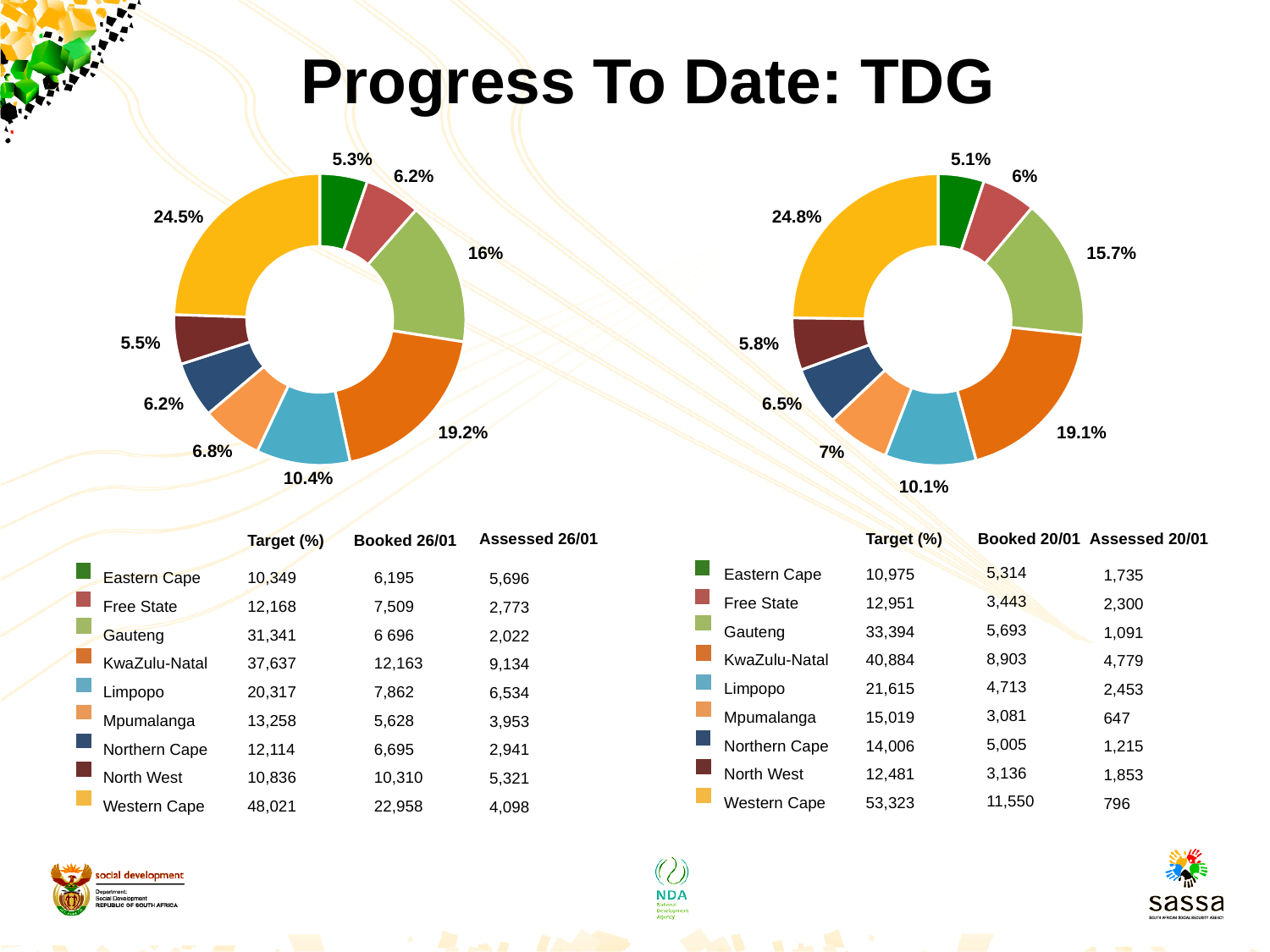
How many slices does the left donut chart have? 9 In the right donut chart, which province has the smallest share? Eastern Cape In the left donut chart, which is larger: the Gauteng share or the Limpopo share? Gauteng In the left donut chart, what share does Limpopo (light blue slice) have? 10.4% In the right donut chart, what is the difference between the Western Cape share (24.8%) and the KwaZulu-Natal share (19.1%)? 5.7% What type of chart is shown on the left side of the slide? Donut (pie) chart In the right donut chart, what share does Mpumalanga (light orange slice) have? 7% In the right donut chart, what share does Gauteng (light green slice) have? 15.7% What is the title of the slide containing the two donut charts? Progress To Date: TDG In the left donut chart, which province has the largest share? Western Cape